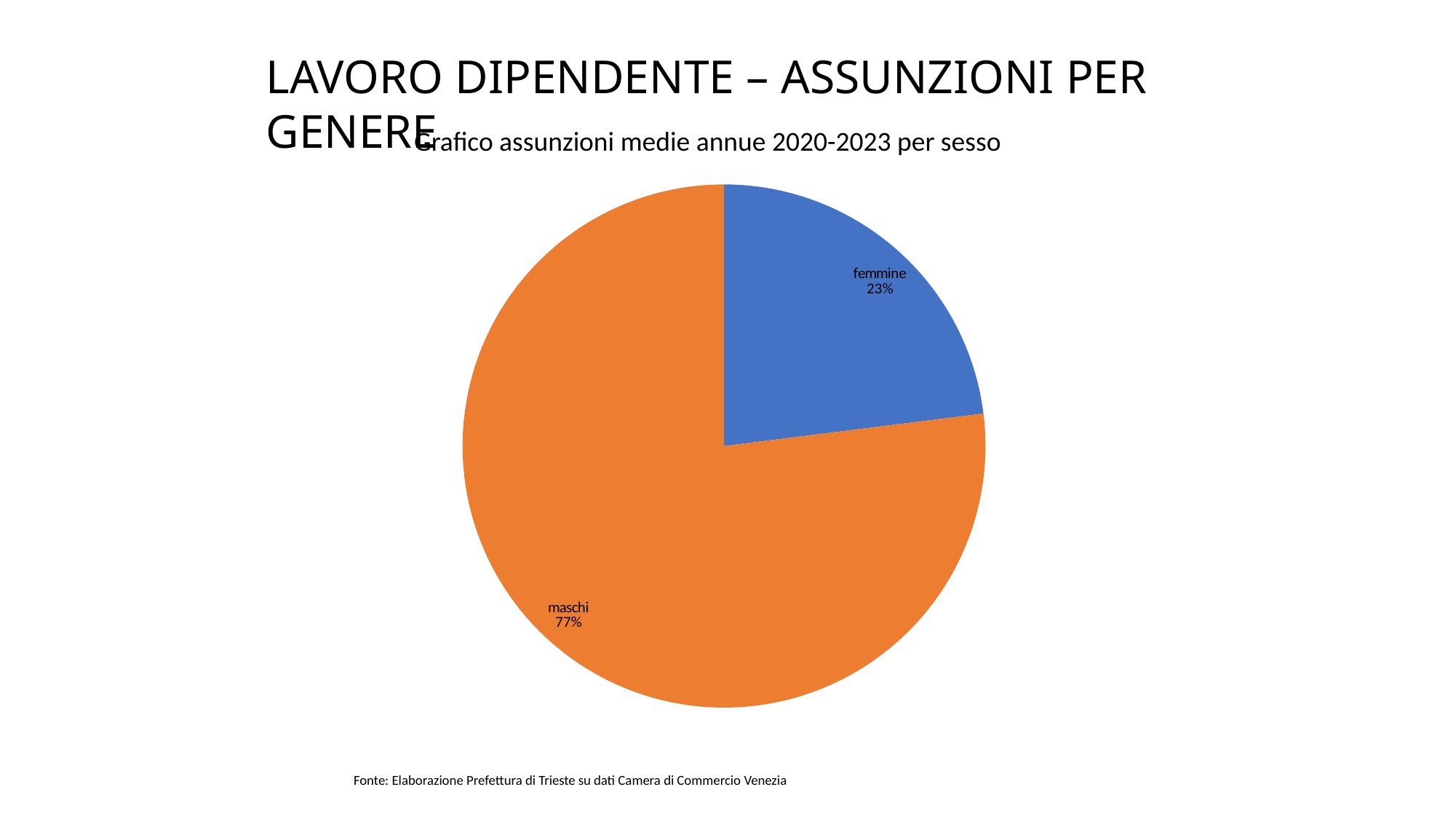
What is the title of the chart? Grafico assunzioni medie annue 2020-2023 per sesso Which slice is larger, 'maschi' or 'femmine'? maschi What kind of chart is shown on the slide? pie chart What colour is the 'femmine' slice? blue How many slices does the pie chart have? 2 Which category has the largest slice of the pie? maschi What is the difference in percentage points between the 'maschi' and 'femmine' slices? 54 Is the share for 'femmine' greater or less than 50%? less What share of the pie does the 'maschi' slice represent? 77% Which category has the smallest slice of the pie? femmine What share of the pie does the 'femmine' slice represent? 23%